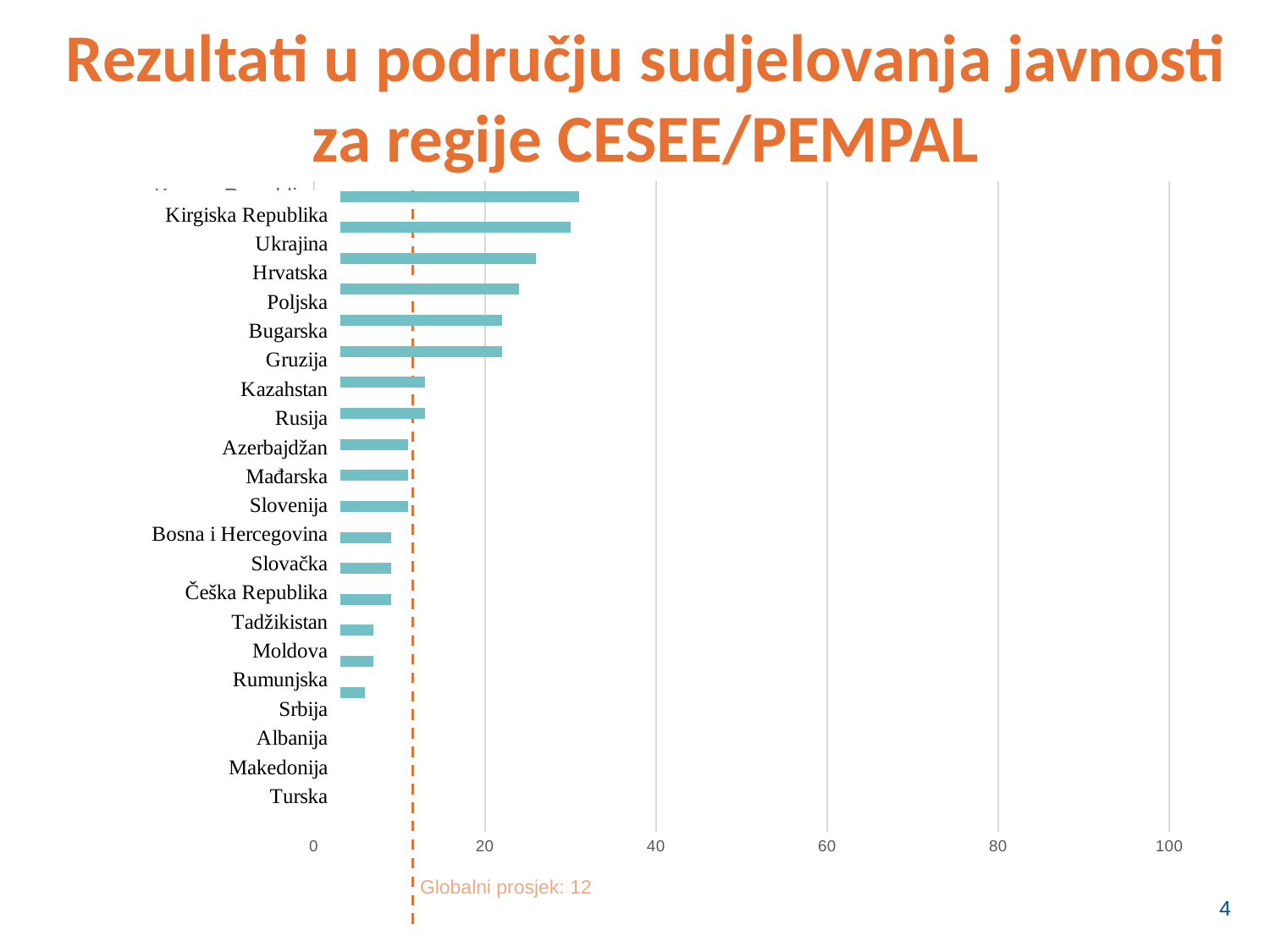
What is the highest value shown on the horizontal axis? 100 What is the global average (Globalni prosjek) value marked by the dashed line? 12 Is the longest bar in the chart greater or less than 20? greater Is the longest bar in the chart greater or less than 40? less What kind of chart is shown on the slide? bar chart Are the bars in the chart drawn horizontally or vertically? horizontally